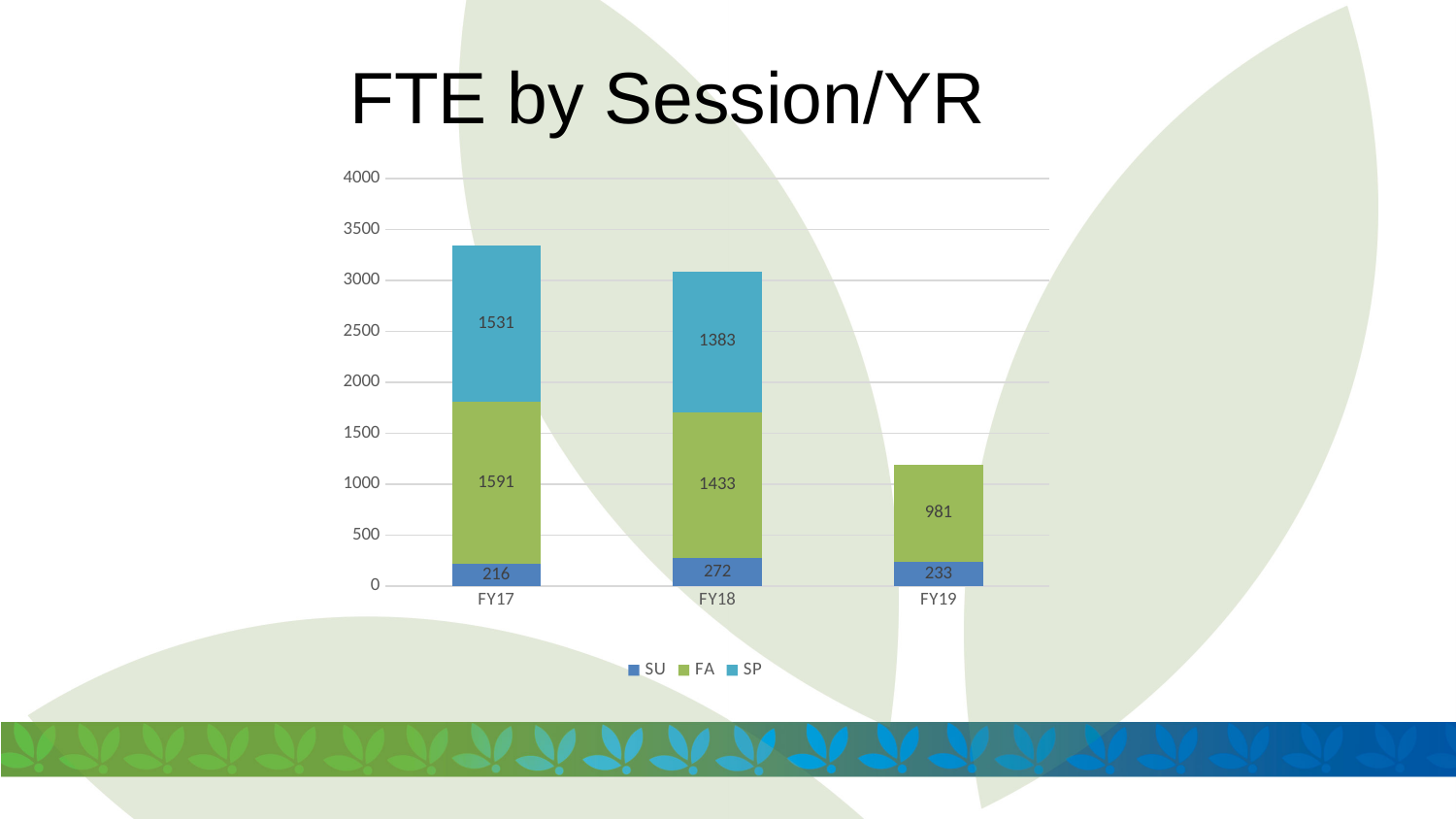
What is the total of the FY18 stacked bar? 3088 Which fiscal year has the lowest SU value? FY17 What is the SP value for FY17? 1531 What kind of chart is shown on the slide? stacked bar chart What is the FA value for FY19? 981 Which fiscal year has the highest FA value? FY17 What is the SU value for FY18? 272 How many fiscal years are shown on the x axis? 3 Which is larger, the SP value for FY17 or the SP value for FY18? FY17 How many series does the legend list? 3 What is the difference between the FA values for FY17 and FY18? 158 Is the total height of the FY19 bar greater or less than 1500? less